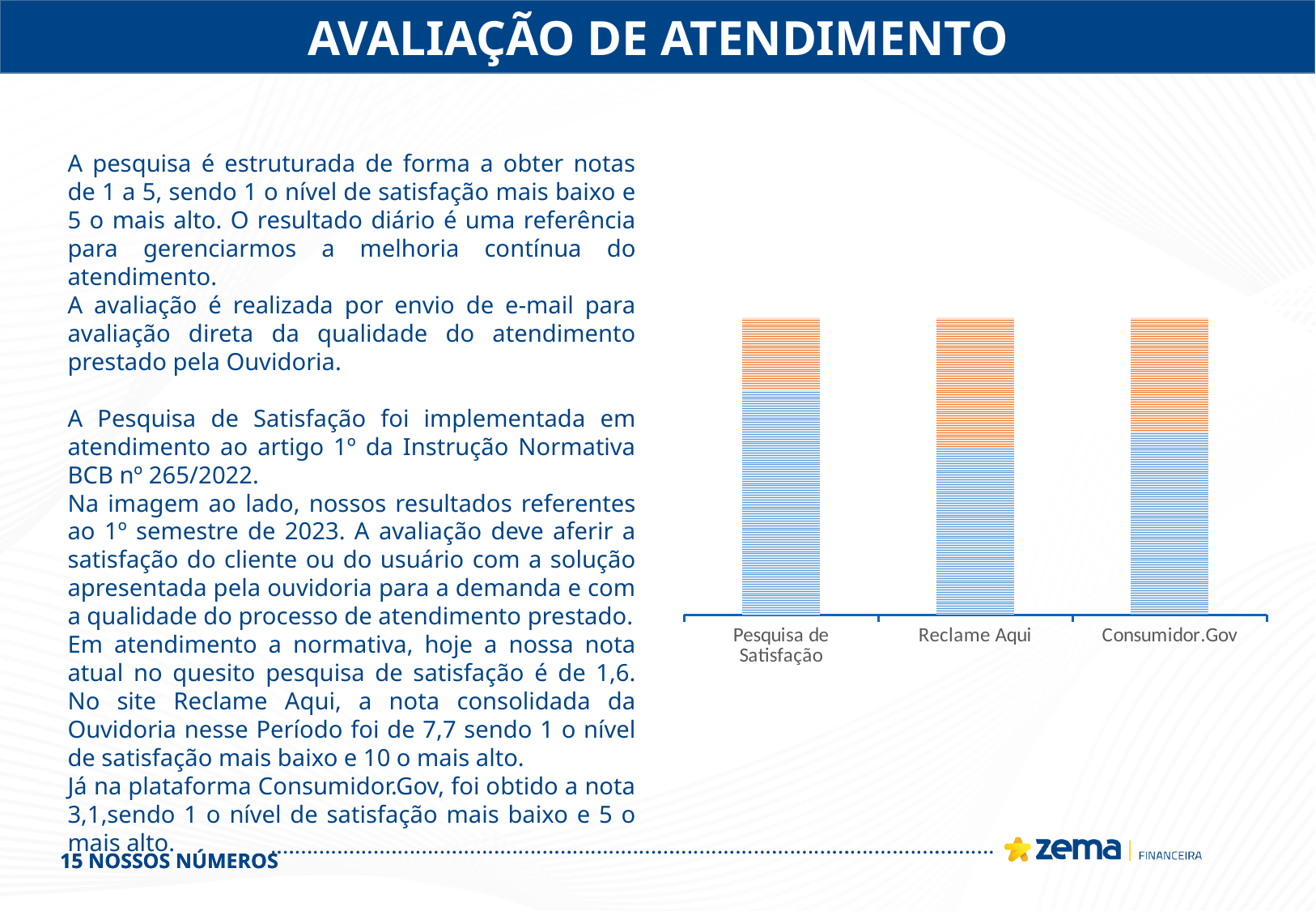
How many categories are shown on the x axis of the chart? 3 What kind of chart is shown on the slide? Bar chart Which category has the smallest orange segment in the chart? Pesquisa de Satisfação Is the orange segment larger for Reclame Aqui or for Pesquisa de Satisfação? Reclame Aqui Are the bars in the chart vertical or horizontal? Vertical What is the label of the first category on the x axis of the chart? Pesquisa de Satisfação Which category has the largest blue segment in the chart? Pesquisa de Satisfação How many coloured segments does each bar in the chart contain? 2 Is the blue segment larger for Pesquisa de Satisfação or for Reclame Aqui? Pesquisa de Satisfação What is the label of the last category on the x axis of the chart? Consumidor.Gov